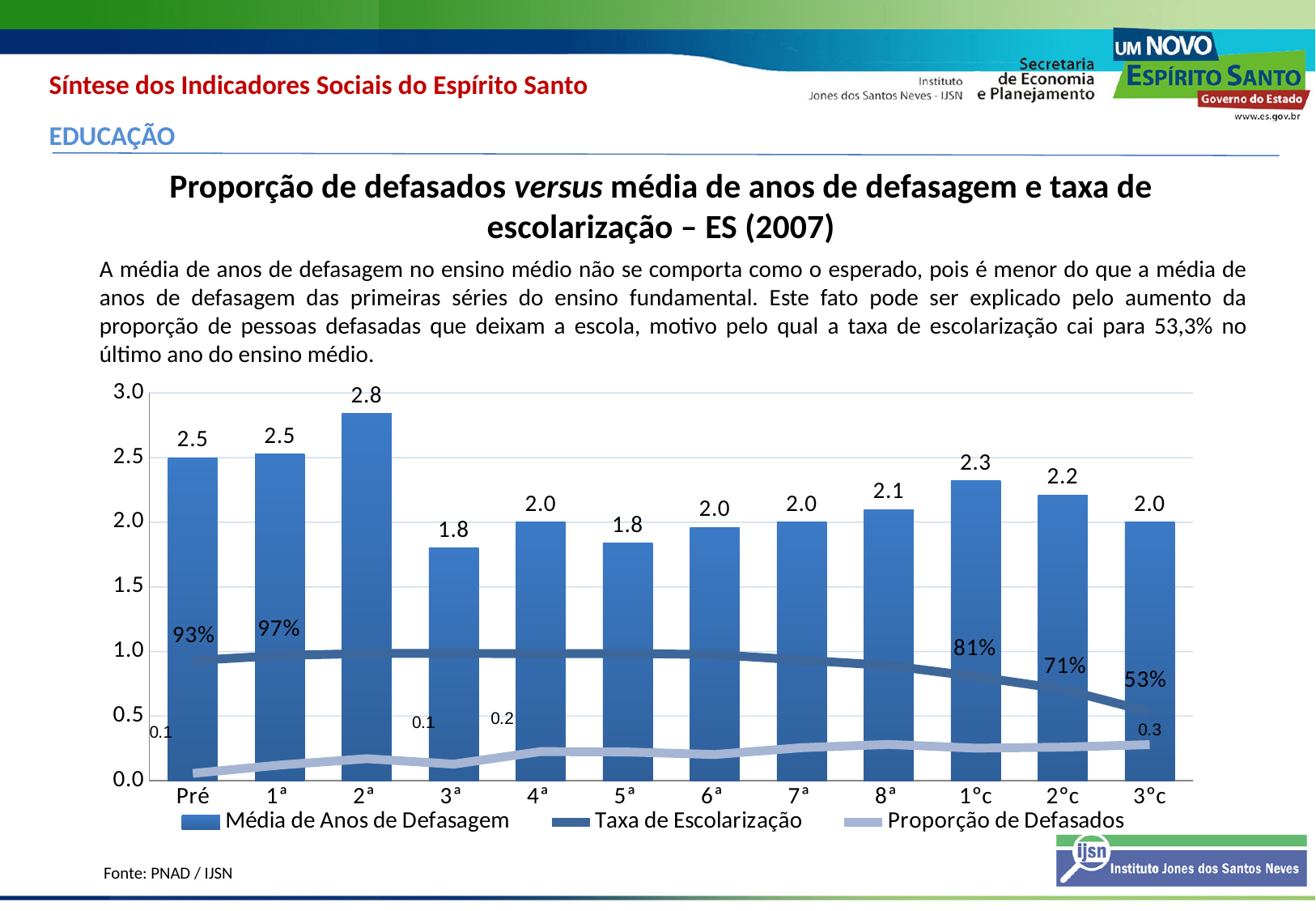
Which has a higher Média de Anos de Defasagem, 1°c or 8ª? 1°c Which category has the highest Média de Anos de Defasagem? 2ª How many series does the legend list? 3 How many categories are shown on the x axis? 12 Among the labelled Taxa de Escolarização values, which category has the lowest? 3°c What is the Taxa de Escolarização shown for 1ª? 97% What is the Taxa de Escolarização shown for 3°c? 53% What is the value of Média de Anos de Defasagem for 2ª? 2.8 Does the Taxa de Escolarização line rise or fall from 1°c to 3°c? fall Is the Média de Anos de Defasagem for 3ª greater or less than 2.0? less What is the difference between the Média de Anos de Defasagem for 2ª and for 3ª? 1.0 What is the value of Proporção de Defasados labelled at 3°c? 0.3